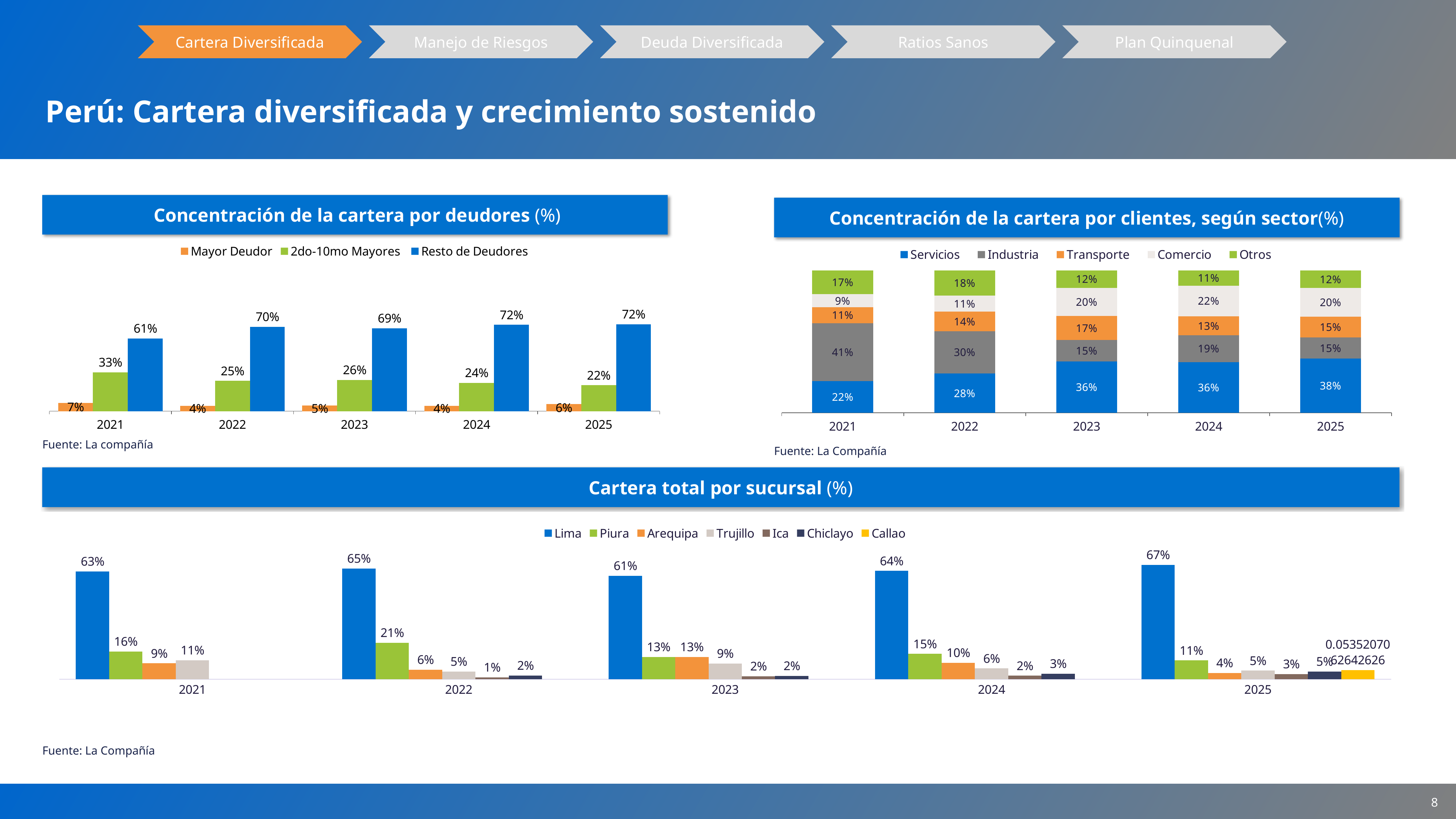
In the chart 'Concentración de la cartera por deudores (%)', what is the difference between Resto de Deudores in 2025 and in 2021? 11% In the chart 'Cartera total por sucursal (%)', how many series does the legend list? 7 In the chart 'Concentración de la cartera por deudores (%)', what is the value for 2do-10mo Mayores in 2021? 33% In the chart 'Concentración de la cartera por deudores (%)', in which year is the Mayor Deudor value highest? 2021 In the chart 'Concentración de la cartera por deudores (%)', what is the value for Resto de Deudores in 2024? 72% In the chart 'Concentración de la cartera por clientes, según sector(%)', does the Servicios value rise or fall from 2021 to 2025? rise In the chart 'Concentración de la cartera por clientes, según sector(%)', what is the value for Industria in 2021? 41% In the chart 'Cartera total por sucursal (%)', which is larger in 2022: Piura or Arequipa? Piura In the chart 'Concentración de la cartera por deudores (%)', how many series does the legend list? 3 In the chart 'Concentración de la cartera por clientes, según sector(%)', what kind of chart is shown? stacked bar chart In the chart 'Cartera total por sucursal (%)', what is the value for Lima in 2025? 67% In the chart 'Concentración de la cartera por clientes, según sector(%)', what is the value for Comercio in 2024? 22%